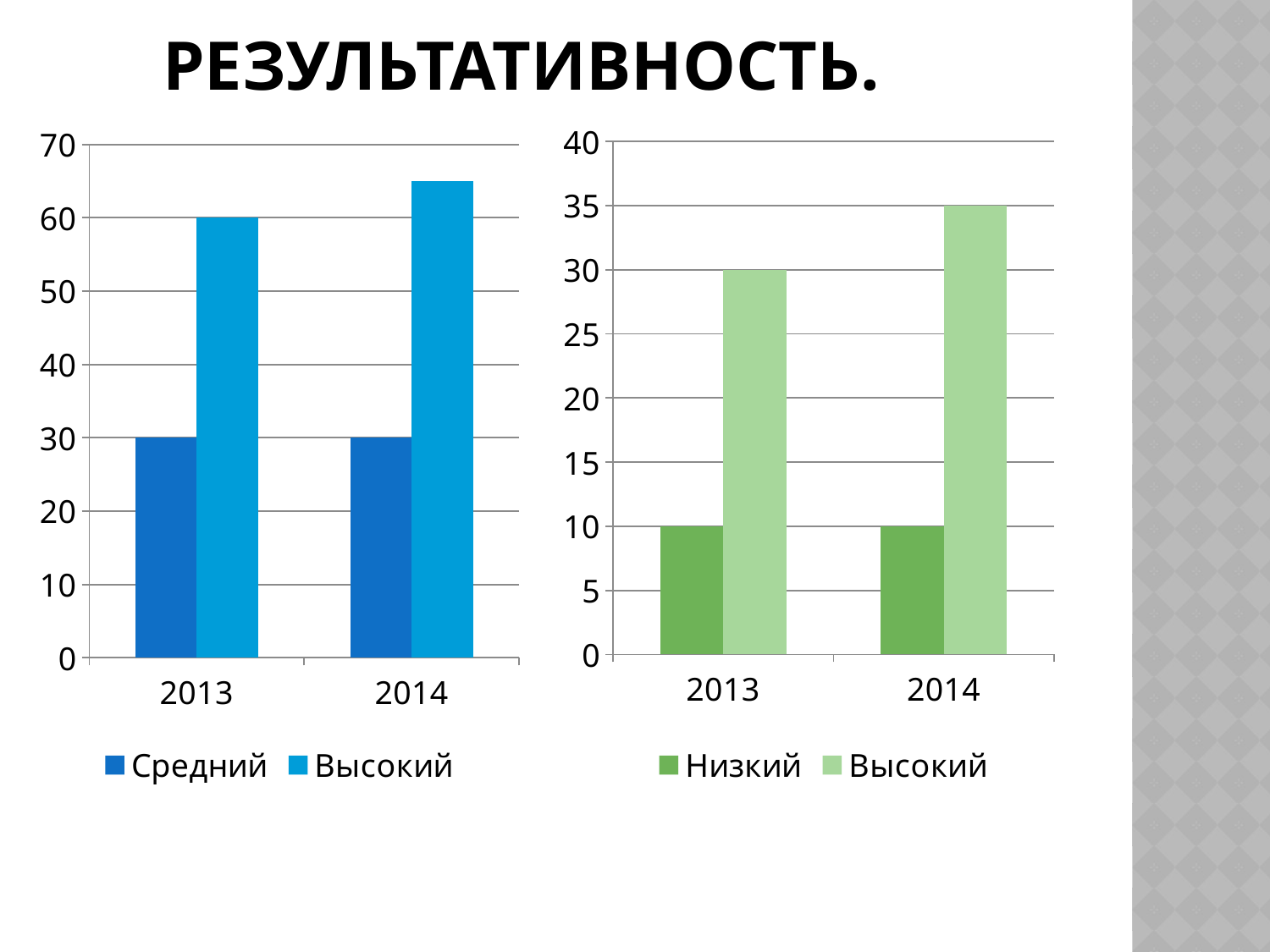
How many series does the legend of the right chart list? 2 On the left chart, what is the value for Высокий in 2013? 60 On the right chart, what is the value for Высокий in 2013? 30 On the left chart, what is the difference between Высокий and Средний in 2013? 30 What kind of chart is the left chart? bar chart On the right chart, what is the value for Низкий in 2014? 10 On the right chart, what is the value for Высокий in 2014? 35 On the right chart, what is the difference between Высокий and Низкий in 2014? 25 On the left chart, which series has the higher value in 2014, Средний or Высокий? Высокий On the right chart, does the value for Высокий rise or fall from 2013 to 2014? rise On the left chart, what is the value for Средний in 2013? 30 On the left chart, is the value for Высокий in 2014 greater or less than 60? greater